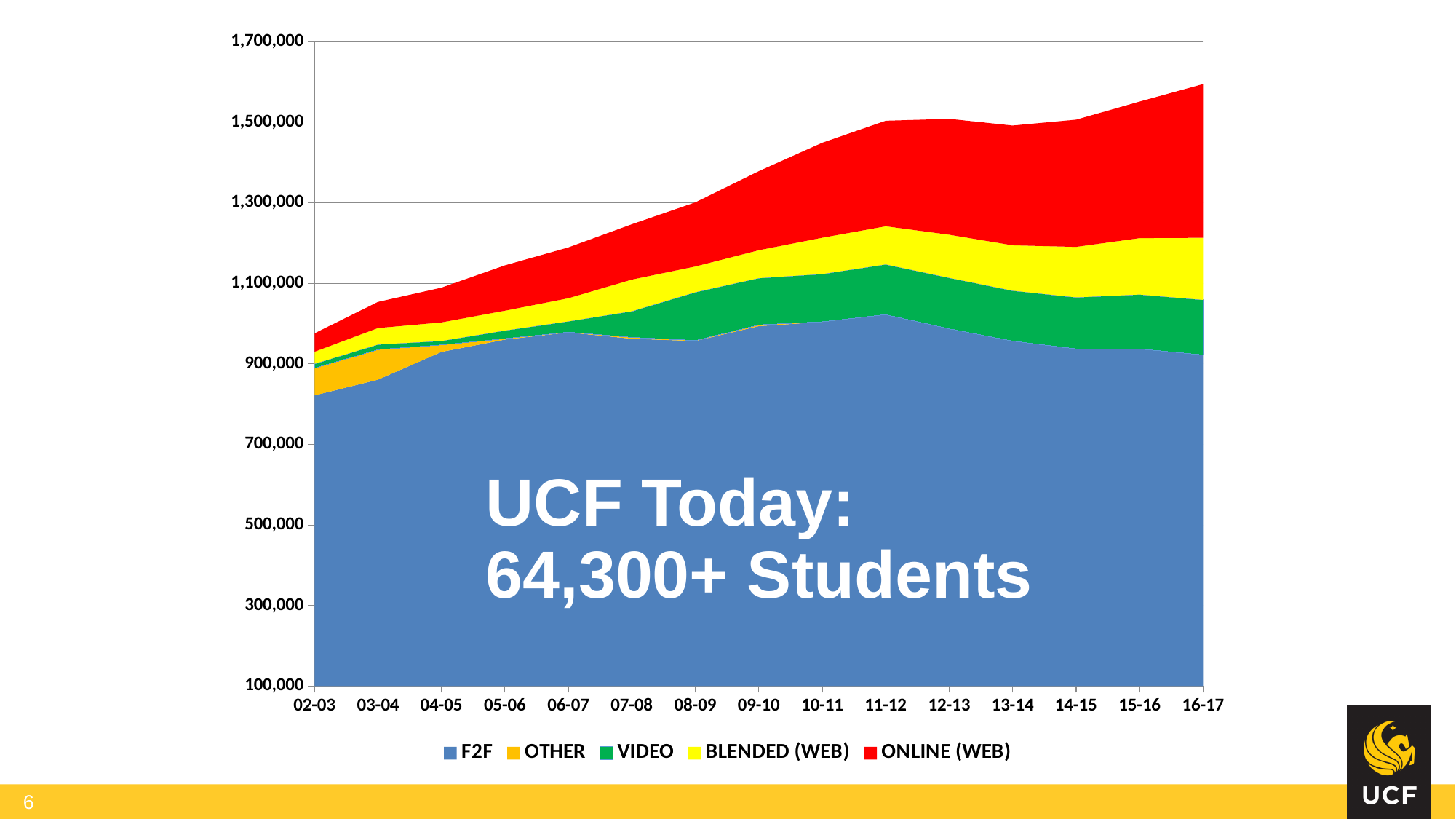
Is the F2F value for 02-03 greater or less than 900,000? less How many series does the legend list? 5 Is the total for 02-03 greater or less than 1,100,000? less What kind of chart is shown on the slide? Stacked area chart How many academic years are shown along the x axis? 15 Does the total across all series generally rise or fall from 02-03 to 16-17? rise Is the total for 10-11 greater or less than 1,300,000? greater Which academic year has the lowest total across all series? 02-03 Which academic year has the highest total across all series? 16-17 Which series is plotted at the bottom of the stack? F2F What colour represents ONLINE (WEB) in the legend? Red